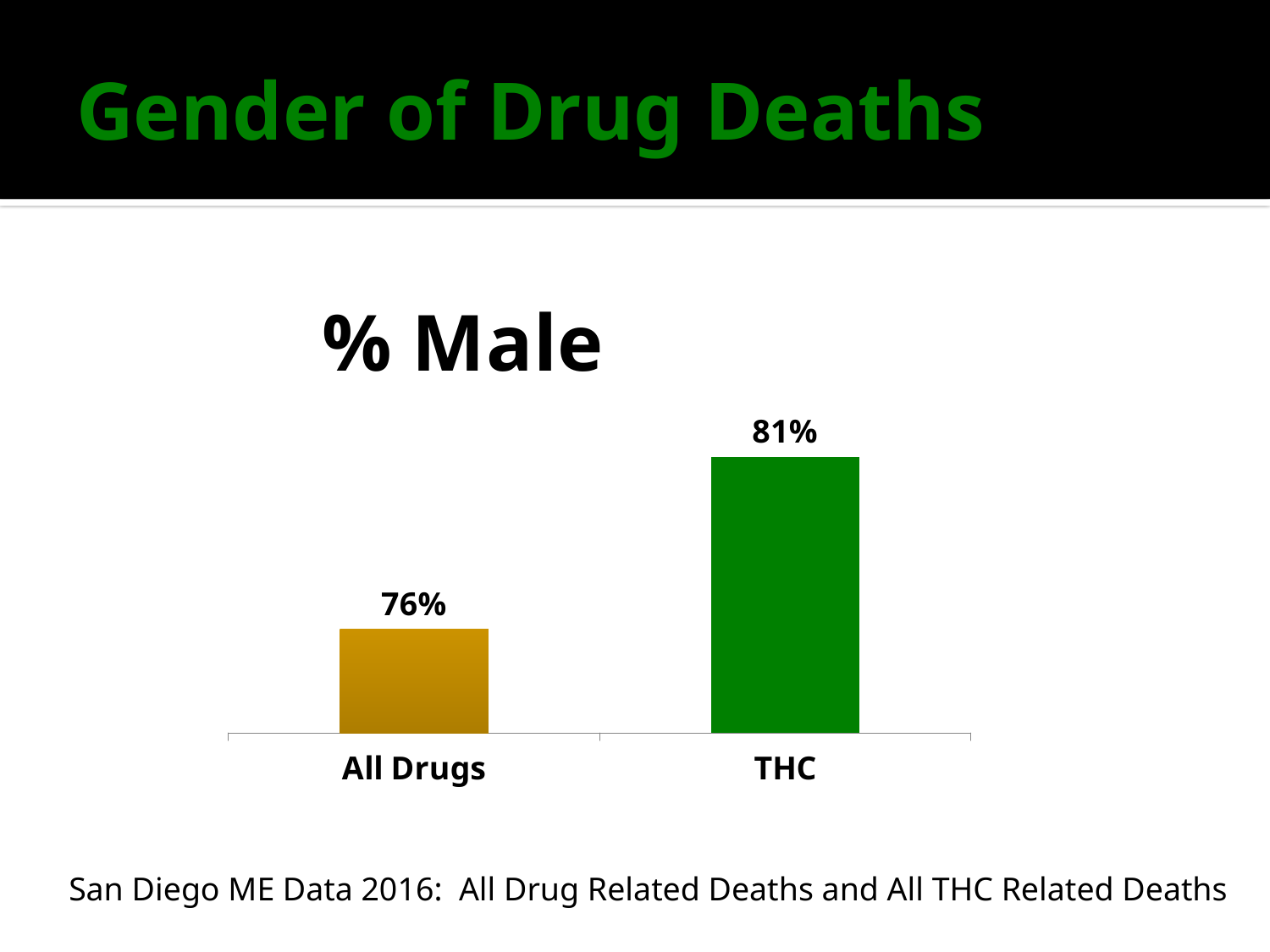
Is the % Male value larger for All Drugs or for THC? THC Do the values rise or fall from All Drugs to THC? Rise What kind of chart is shown on the slide? Bar chart What is the difference in % Male between THC and All Drugs? 5% What is the title of the chart? % Male Which category has the higher % Male value? THC How many categories are shown on the chart? 2 What is the % Male value for THC? 81% Which category has the lower % Male value? All Drugs What colour is the bar for THC? Green What is the % Male value for All Drugs? 76%